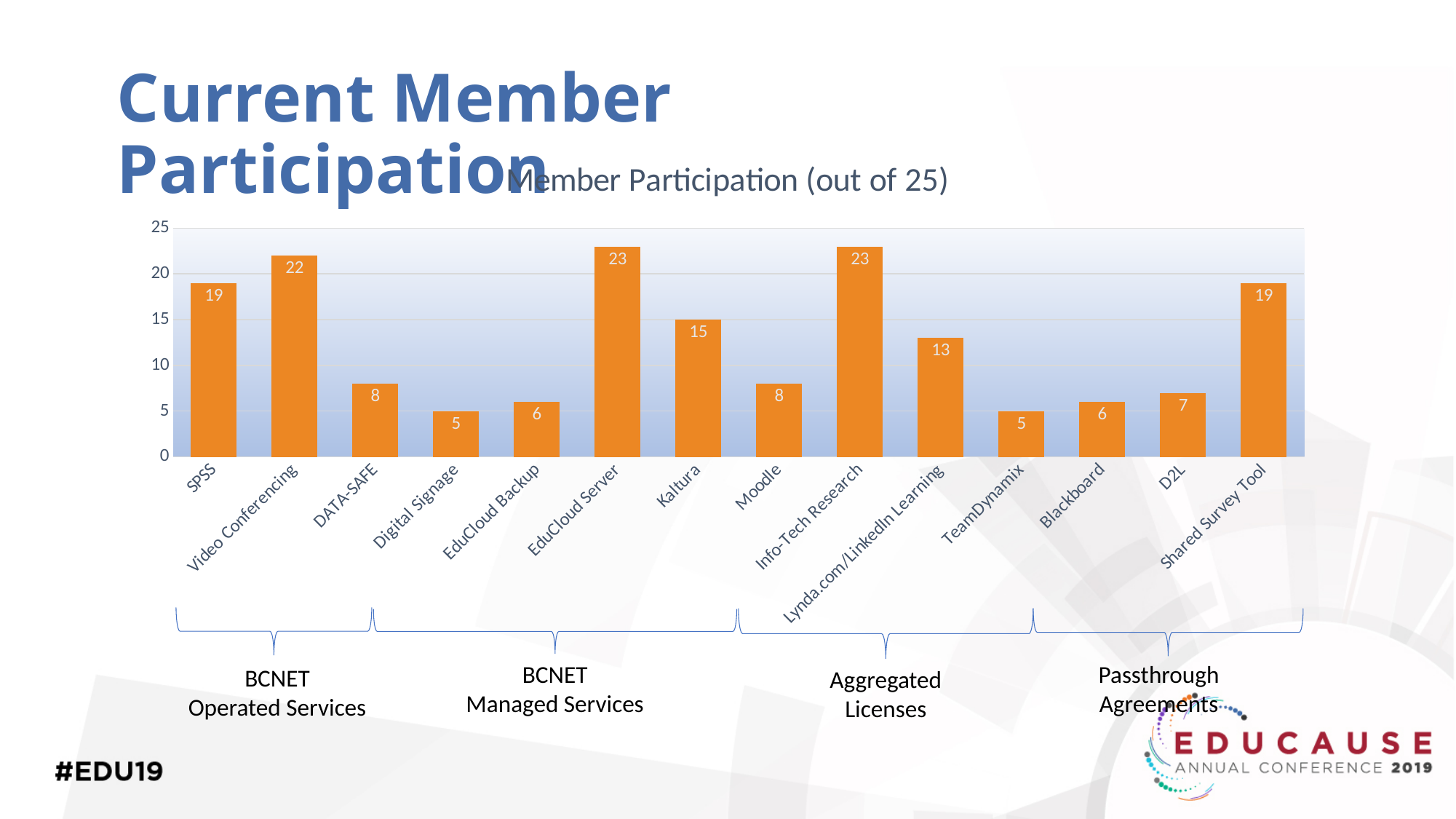
What is the value for Video Conferencing? 22 What is the difference between the values for EduCloud Server and EduCloud Backup? 17 What is the value for Lynda.com/LinkedIn Learning? 13 What kind of chart is shown on the slide? bar chart What is the lowest value shown on the chart? 5 What is the value for Shared Survey Tool? 19 Which has a larger value, SPSS or DATA-SAFE? SPSS What is the highest value shown on the chart? 23 Is the value for Moodle greater or less than 10? less What is the title of the chart? Member Participation (out of 25) How many categories are shown on the chart? 14 What is the value for Kaltura? 15